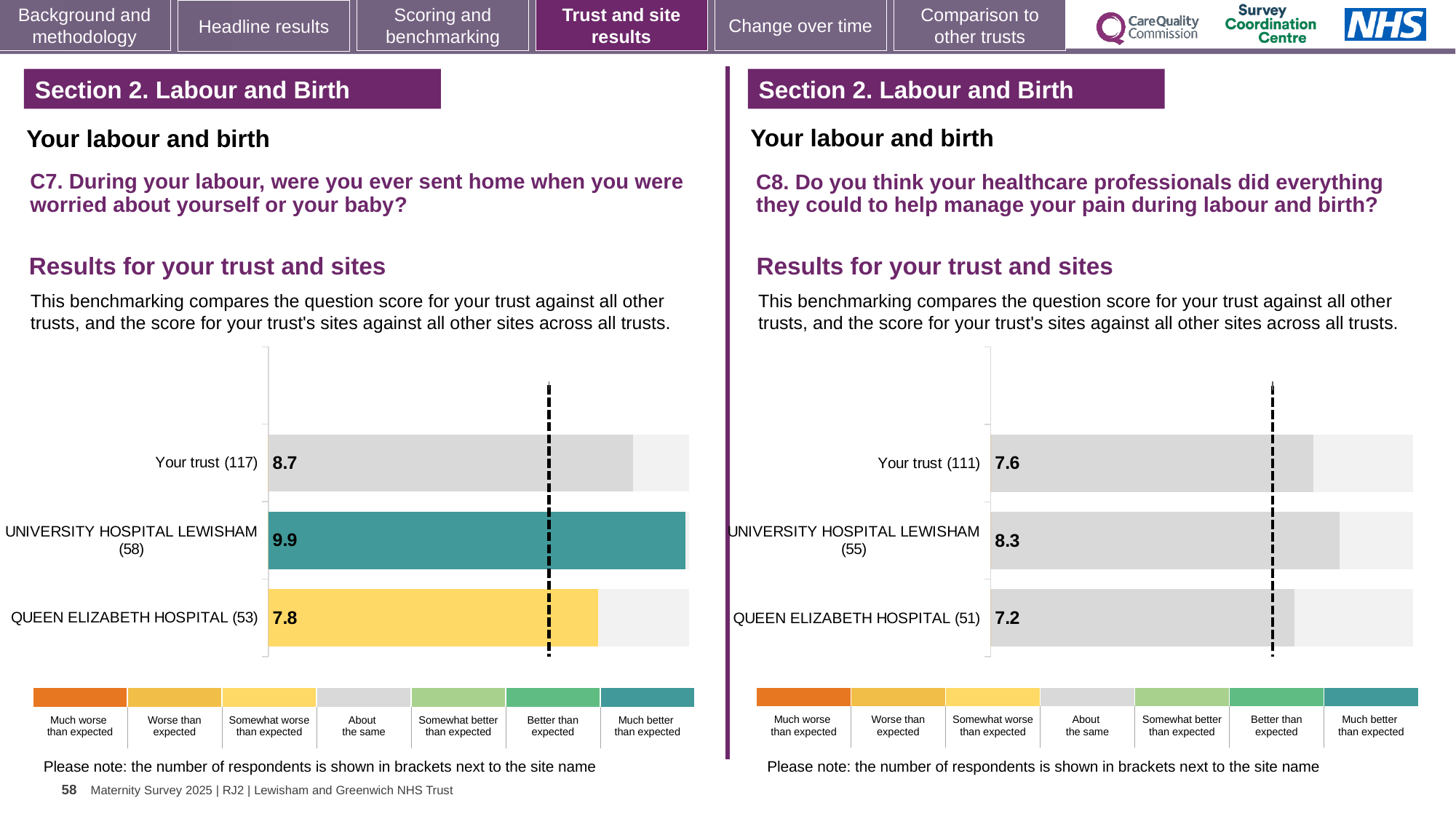
How many bars are shown in the C7 chart on the left? 3 In the C7 chart on the left, what is the score for Your trust? 8.7 In the C7 chart on the left, how many respondents are shown in brackets for Your trust? 117 In the C7 chart on the left, what is the score for University Hospital Lewisham? 9.9 In the C8 chart on the right, which has the larger score, Your trust or University Hospital Lewisham? University Hospital Lewisham What type of chart is used in the C8 chart on the right? Bar chart In the C8 chart on the right, what is the score for Queen Elizabeth Hospital? 7.2 In the C7 chart on the left, what is the difference between the scores for University Hospital Lewisham and Queen Elizabeth Hospital? 2.1 In the C8 chart on the right, what is the score for University Hospital Lewisham? 8.3 In the C8 chart on the right, what is the difference between the scores for Your trust and Queen Elizabeth Hospital? 0.4 In the C8 chart on the right, which site or trust has the lowest score? Queen Elizabeth Hospital In the C7 chart on the left, which site or trust has the highest score? University Hospital Lewisham